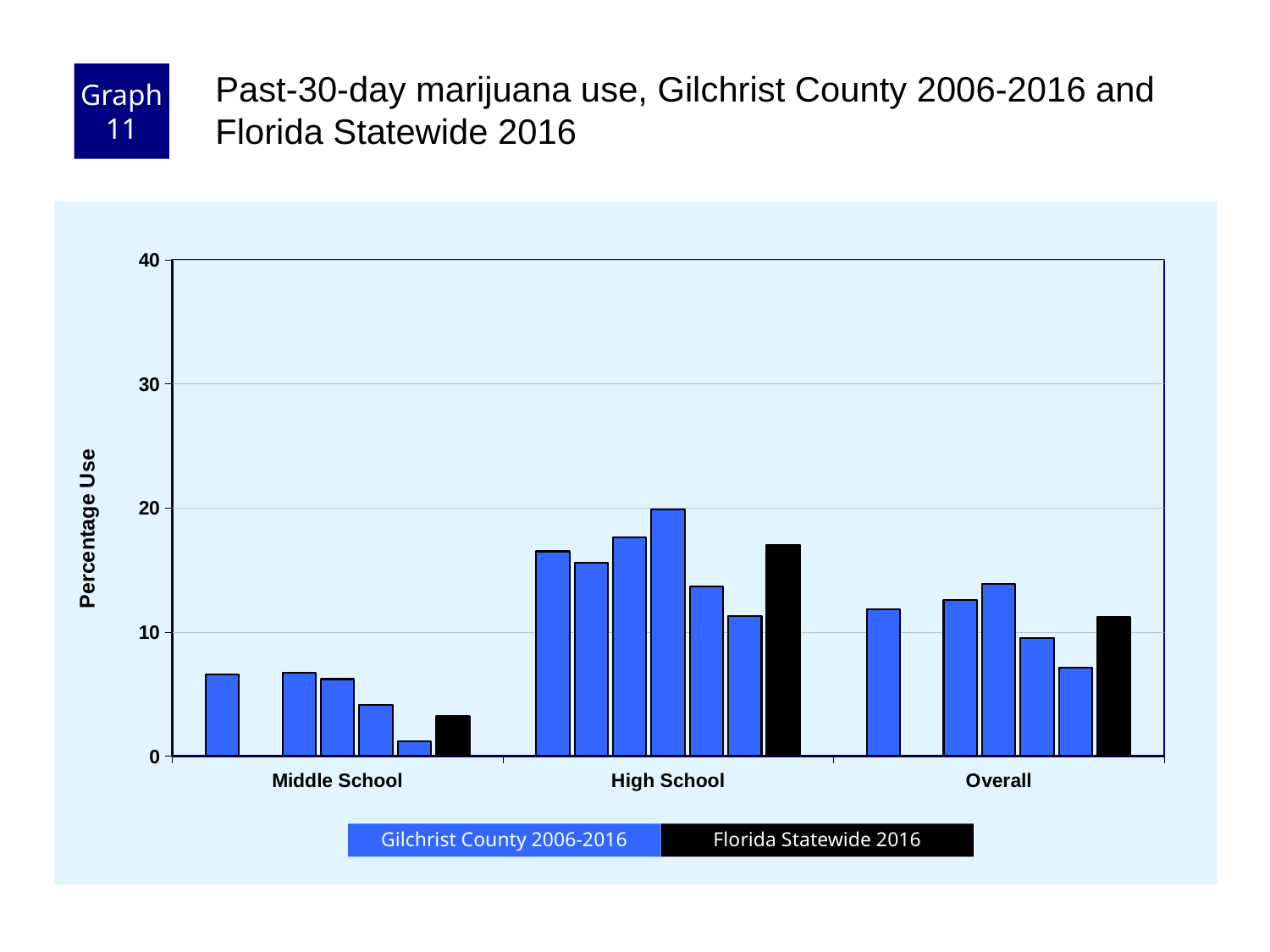
What is the label on the y axis? Percentage Use Is the Florida Statewide 2016 value for High School greater or less than 10? greater Is the Florida Statewide 2016 value for Overall greater or less than 20? less Which colour represents Florida Statewide 2016 in the legend? black Which category has the tallest bar in the chart? High School How many series does the legend list? 2 Which category has the shortest bar in the chart? Middle School Which is larger, the Florida Statewide 2016 value for Middle School or for High School? High School How many categories are shown on the x axis? 3 Is the Florida Statewide 2016 value for Middle School greater or less than 10? less What kind of chart is shown on the slide? bar chart